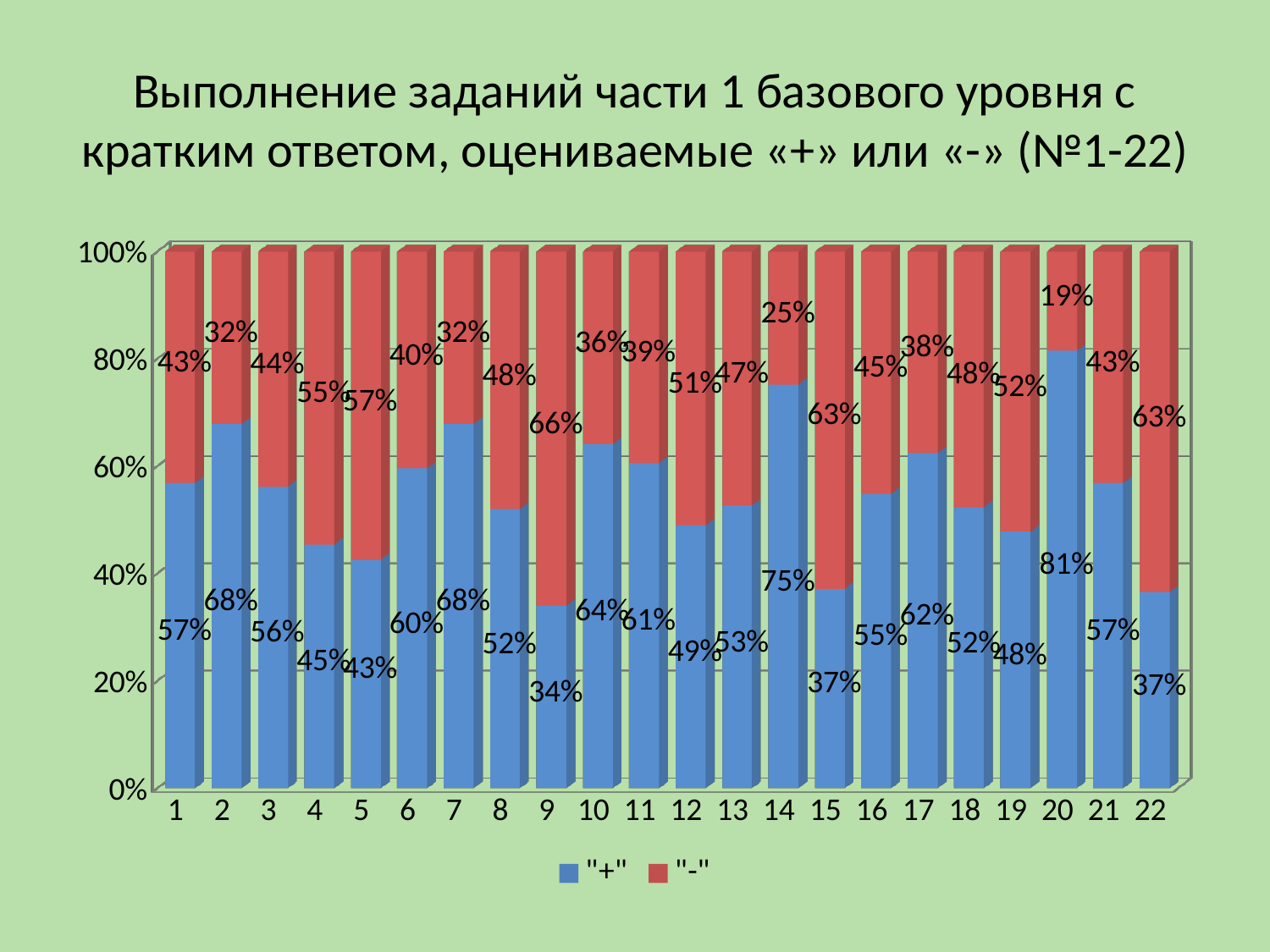
What is the "-" value for task 9? 66% Which task has the highest "+" value? 20 Which task has the lowest "+" value? 9 How many tasks (categories) are shown on the x axis? 22 How many series does the legend list? 2 What is the "+" value for task 14? 75% Which task has the lowest "-" value? 20 Which is larger, the "+" value for task 2 or the "+" value for task 4? task 2 What is the difference between the "+" values for task 20 and task 9? 47% Which colour represents the "-" series? red What is the "+" value for task 20? 81% What kind of chart is shown on the slide? stacked bar chart